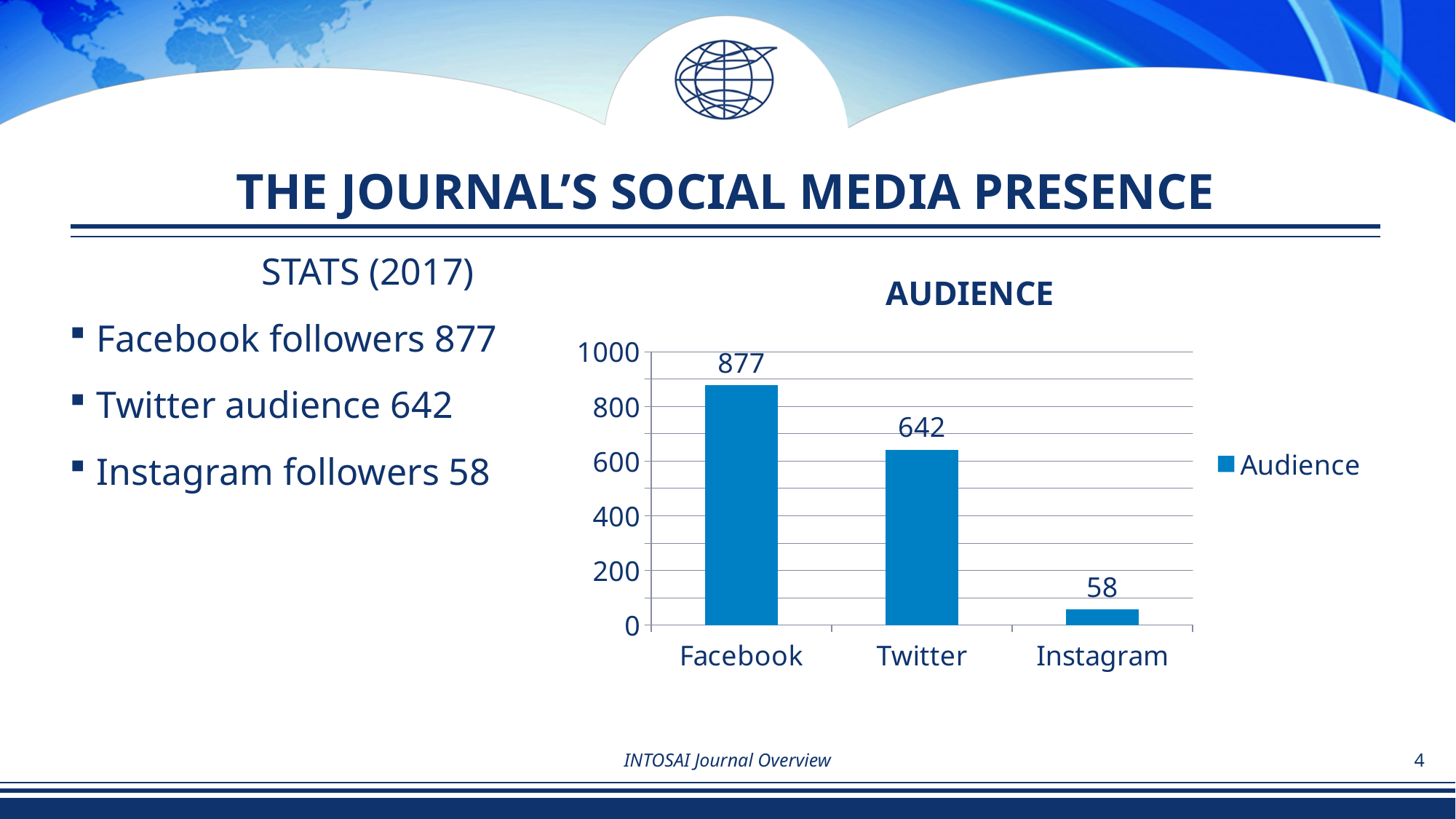
What is the audience value for Twitter? 642 What is the audience value for Facebook? 877 How many series does the chart legend list? 1 Which has a larger audience, Twitter or Instagram? Twitter Which platform has the highest audience? Facebook How many platforms are shown on the x axis of the chart? 3 What type of chart is shown on the slide? Bar chart What is the audience value for Instagram? 58 Is the audience value for Facebook greater or less than 800? greater Which platform has the lowest audience? Instagram What is the difference between the Facebook and Twitter audience values? 235 What is the difference between the Twitter and Instagram audience values? 584